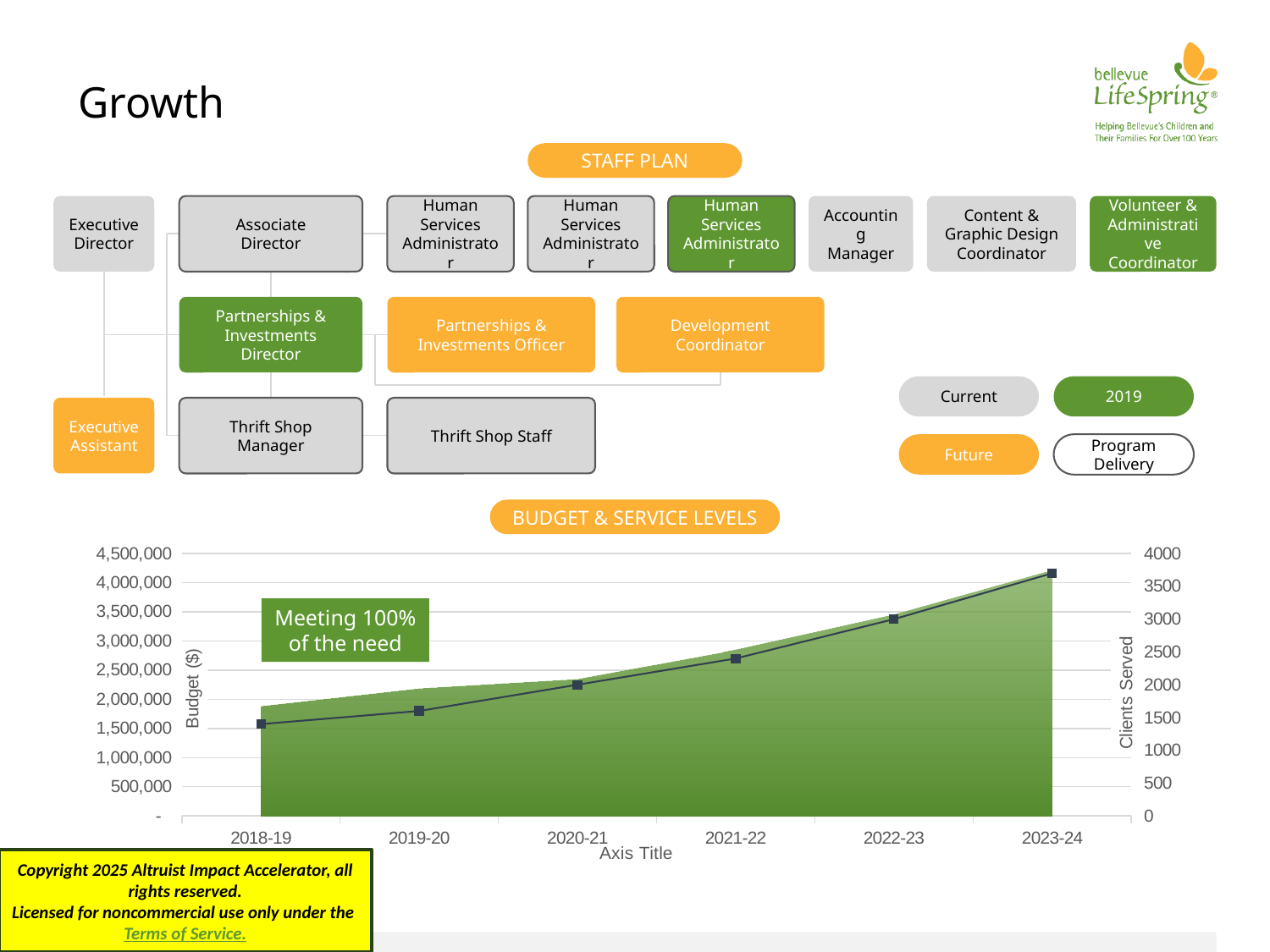
In the BUDGET & SERVICE LEVELS chart, is the plotted value for 2018-19 greater or less than 2,000,000 on the Budget ($) axis? less In the BUDGET & SERVICE LEVELS chart, is the plotted value for 2023-24 greater or less than 3,500,000 on the Budget ($) axis? greater In the BUDGET & SERVICE LEVELS chart, is the plotted value for 2019-20 greater or less than 2,500,000 on the Budget ($) axis? less What is the title of the right-hand vertical axis in the BUDGET & SERVICE LEVELS chart? Clients Served Which fiscal year has the highest plotted value in the BUDGET & SERVICE LEVELS chart? 2023-24 What is the title of the chart on the slide? BUDGET & SERVICE LEVELS Which fiscal year has the lowest plotted value in the BUDGET & SERVICE LEVELS chart? 2018-19 How many fiscal years are plotted along the x axis of the BUDGET & SERVICE LEVELS chart? 6 What kind of chart is the BUDGET & SERVICE LEVELS chart? combination area and line chart In the BUDGET & SERVICE LEVELS chart, which is larger, the value for 2023-24 or the value for 2018-19? 2023-24 In the BUDGET & SERVICE LEVELS chart, do the plotted values rise or fall from 2018-19 to 2023-24? rise